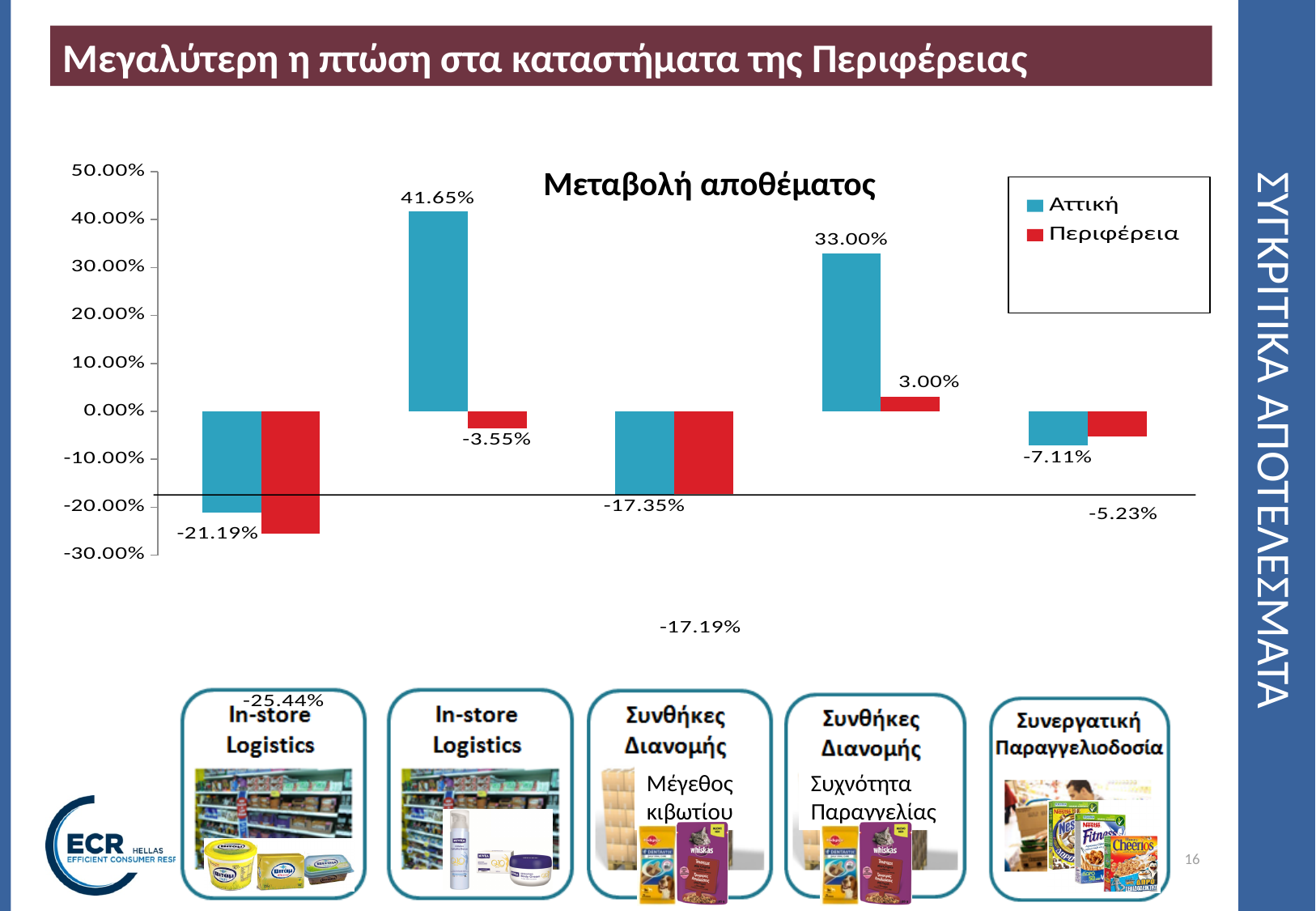
How many series does the chart legend list? 2 What is the title of the chart? Μεταβολή αποθέματος What is the difference between the Αττική value (33.00%) and the Περιφέρεια value (3.00%) in the fourth group of bars? 30.00 percentage points How many groups of bars (categories) are plotted in the chart? 5 What is the Αττική value for the Συνεργατική Παραγγελιοδοσία category (last group of bars)? -7.11% In the first group of bars, which series has the larger (less negative) value, Αττική or Περιφέρεια? Αττική What are the two series named in the chart legend? Αττική and Περιφέρεια What is the Αττική value for the second group of bars (the second In-store Logistics category)? 41.65% What kind of chart is shown on the slide? Bar chart Which group of bars has the highest Αττική value? The second group (In-store Logistics), 41.65% What is the Περιφέρεια value for the Συχνότητα Παραγγελίας category (fourth group of bars)? 3.00% Which group of bars has the lowest Αττική value? The first group (In-store Logistics), -21.19%